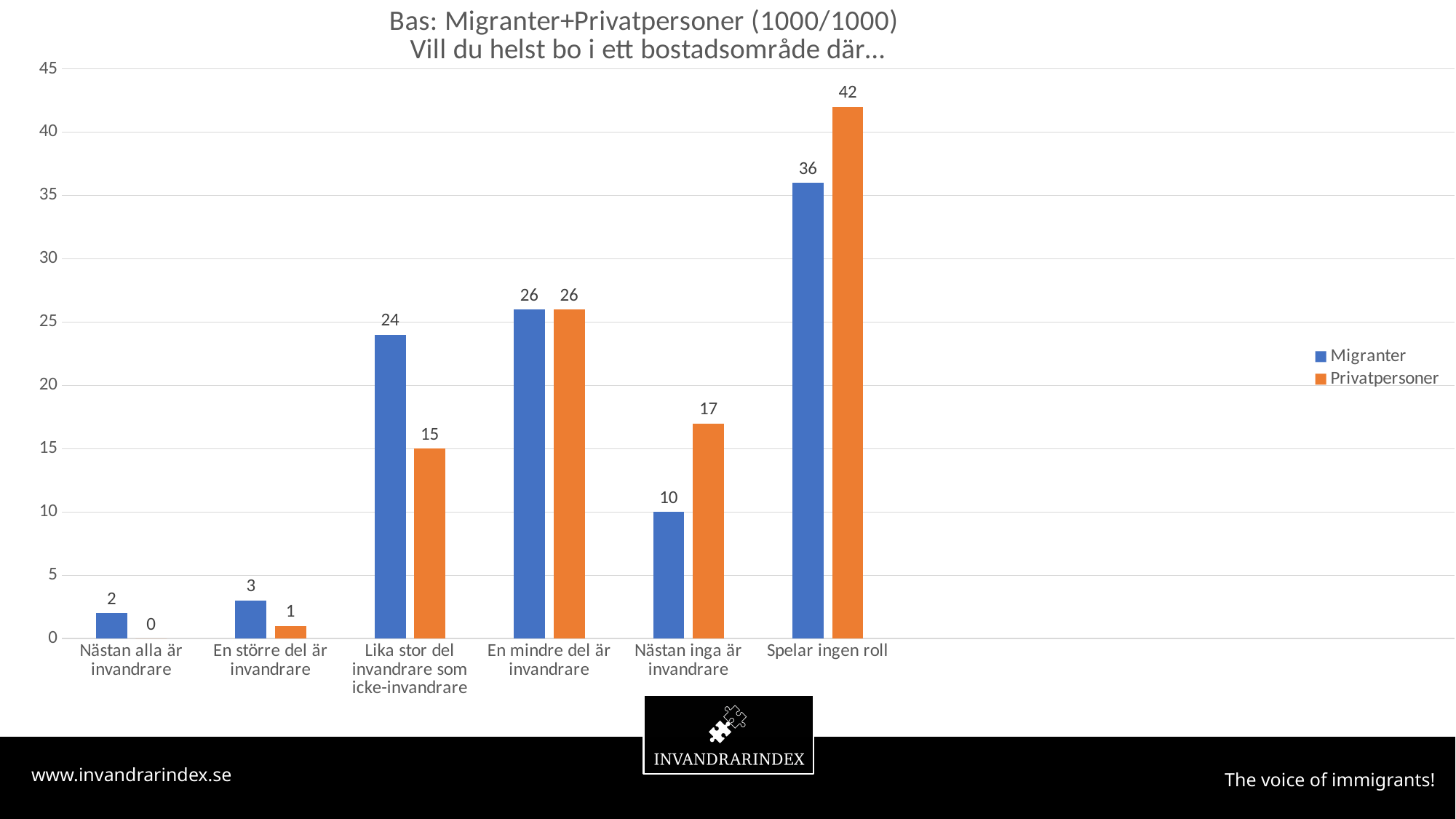
Which colour represents the Privatpersoner series? Orange What is the difference between the Privatpersoner and Migranter values for "Spelar ingen roll"? 6 Which category has the lowest value for Migranter? Nästan alla är invandrare Which category has the highest value for Privatpersoner? Spelar ingen roll What is the value for Privatpersoner in the category "Lika stor del invandrare som icke-invandrare"? 15 What is the value for Migranter in the category "Spelar ingen roll"? 36 How many series does the legend list? 2 What kind of chart is shown on the slide? Bar chart What is the value for Privatpersoner in the category "Nästan alla är invandrare"? 0 How many categories are shown on the x axis? 6 What is the difference between the Migranter and Privatpersoner values for "Lika stor del invandrare som icke-invandrare"? 9 In the category "Nästan inga är invandrare", which series has the larger value, Migranter or Privatpersoner? Privatpersoner